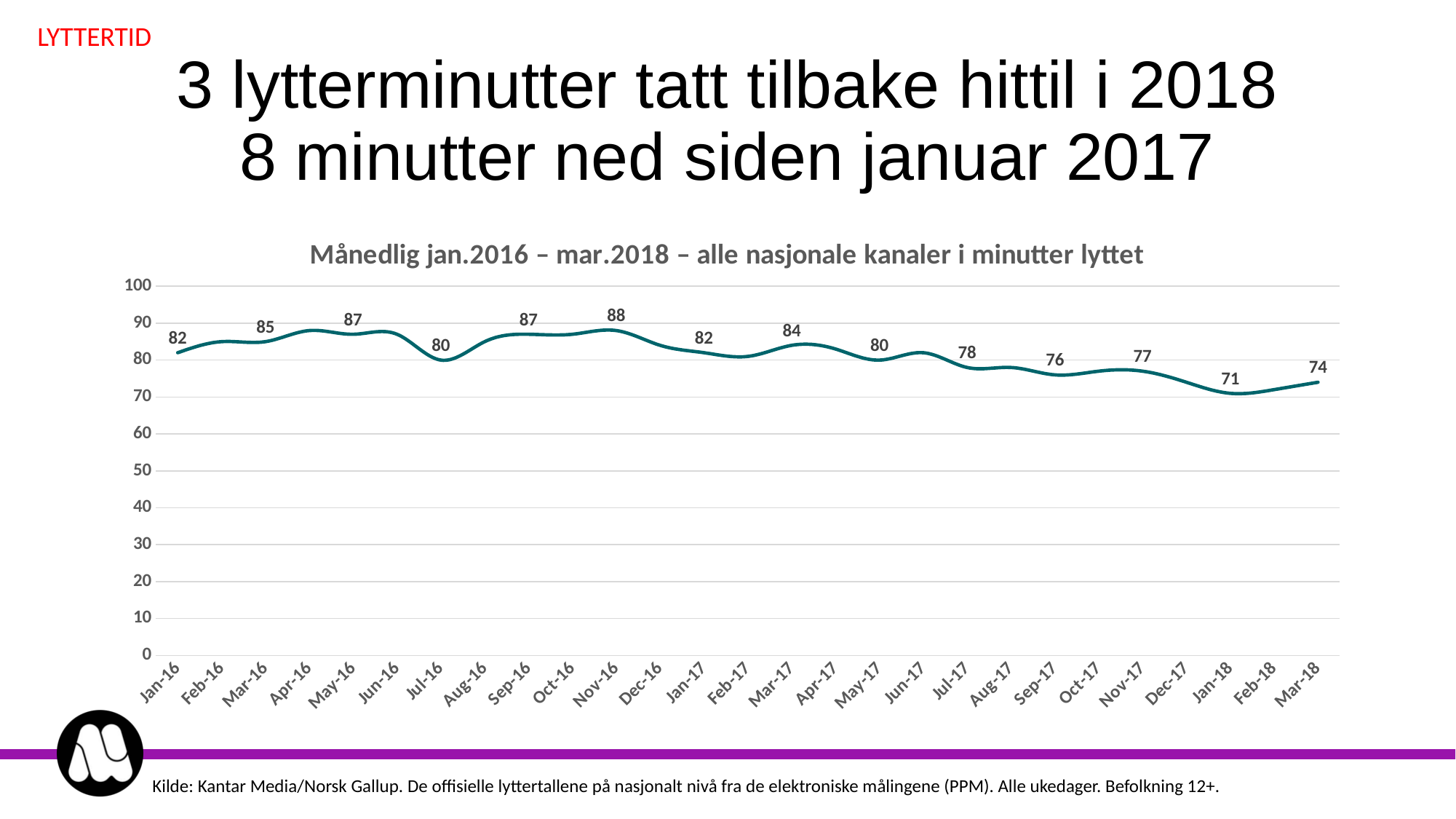
What kind of chart is shown on the slide? line chart Which is larger, the value for May-16 or the value for Sep-17? May-16 Do the values generally rise or fall from Jan-16 to Mar-18? fall What is the difference between the value for Jan-17 and the value for Mar-18? 8 What is the value for Mar-18? 74 How many monthly data points are plotted on the x axis? 27 What is the value for Nov-16? 88 What is the difference between the value for Mar-18 and the value for Jan-18? 3 What is the value for Jan-18? 71 Is the value for Apr-16 greater or less than 80? greater Which month has the lowest labelled value? Jan-18 Which month has the highest labelled value? Nov-16